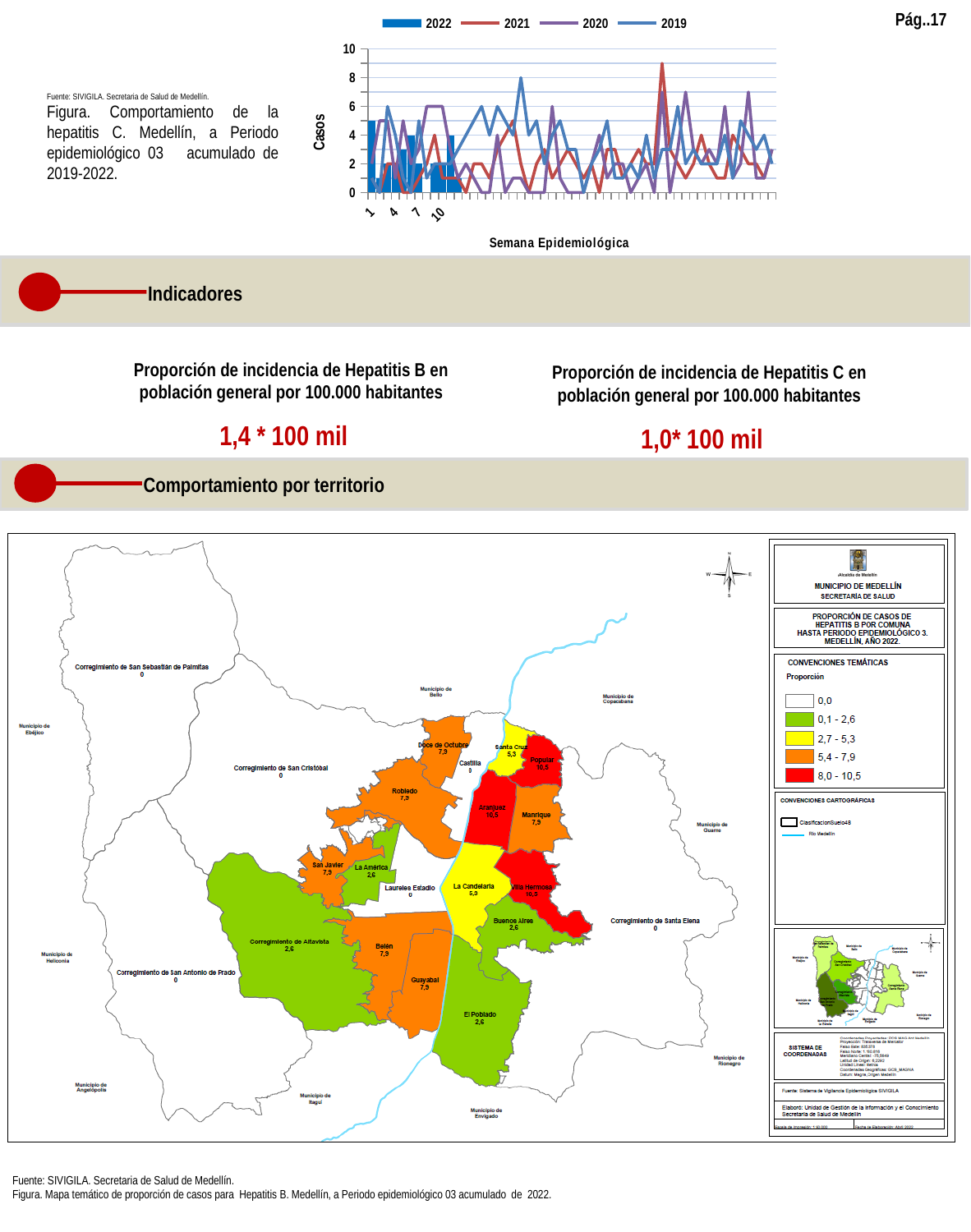
What is the label of the vertical axis of the hepatitis C chart? Casos In the hepatitis C chart, is the 2022 value at week 1 greater or less than 4? greater In the hepatitis C chart, which series reaches the highest peak? 2021 In the hepatitis C chart, is the highest peak of the 2021 series greater or less than 8? greater How many series does the legend of the hepatitis C chart list? 4 In the hepatitis C chart, is the highest peak of the 2020 series greater or less than 8? less What kind of chart is the hepatitis C chart at the top of the slide? Combined bar and line chart In the hepatitis C chart, which series is drawn as bars rather than a line? 2022